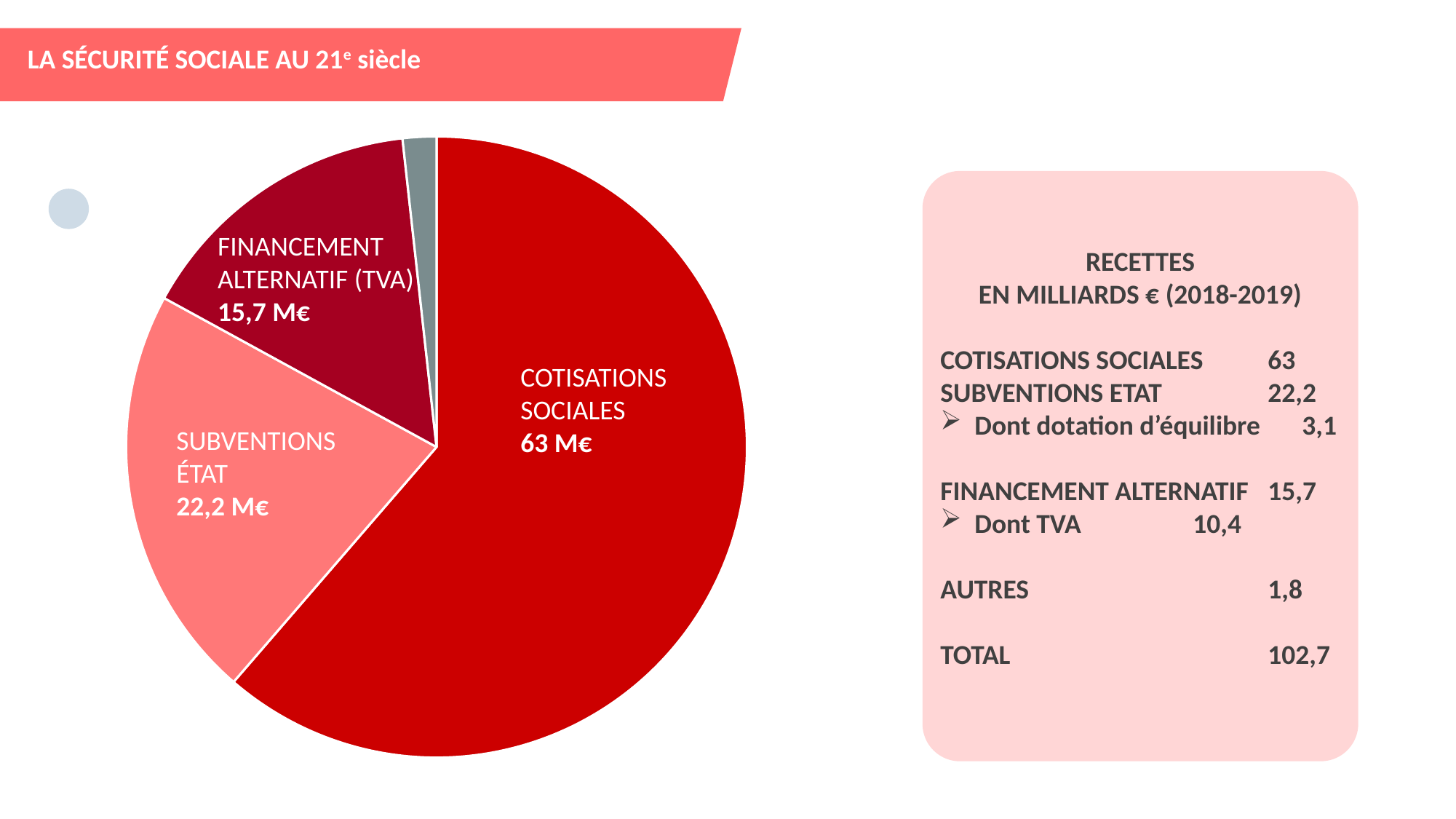
What is the difference between the SUBVENTIONS ÉTAT value and the FINANCEMENT ALTERNATIF (TVA) value in the pie chart? 6,5 M€ What value is shown for FINANCEMENT ALTERNATIF (TVA) in the pie chart? 15,7 M€ Which is larger in the pie chart, SUBVENTIONS ÉTAT or FINANCEMENT ALTERNATIF (TVA)? SUBVENTIONS ÉTAT What colour is the COTISATIONS SOCIALES slice of the pie chart? Red How many slices does the pie chart have? 4 What value is shown for SUBVENTIONS ÉTAT in the pie chart? 22,2 M€ What is the total of the recettes listed in the text box next to the pie chart? 102,7 What is the difference between the COTISATIONS SOCIALES value and the SUBVENTIONS ÉTAT value in the pie chart? 40,8 M€ What kind of chart is shown on the slide? Pie chart What value is shown for COTISATIONS SOCIALES in the pie chart? 63 M€ Which of the three labeled slices of the pie chart is the smallest? FINANCEMENT ALTERNATIF (TVA) Which slice of the pie chart is the largest? COTISATIONS SOCIALES